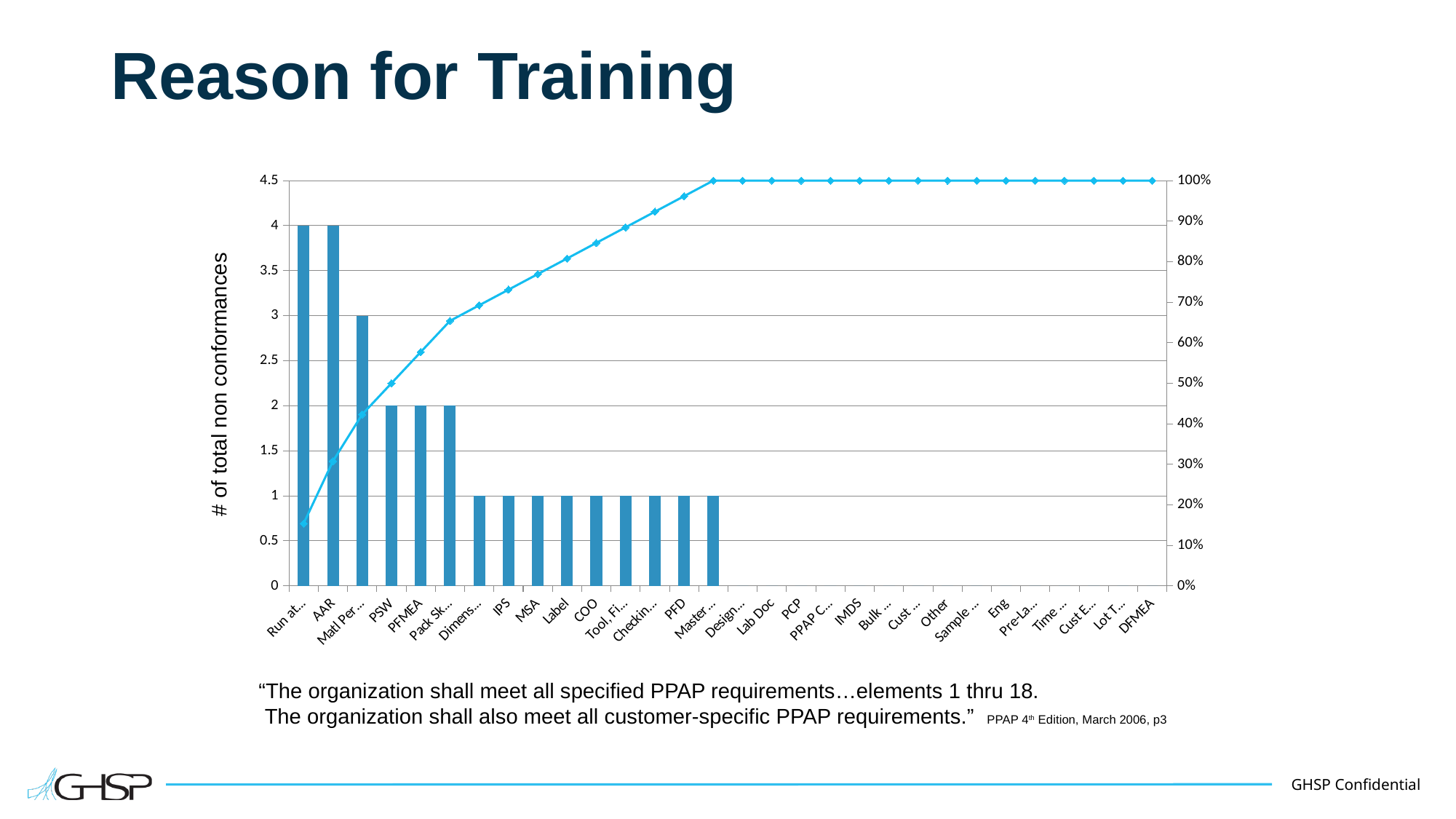
What is the cumulative percentage shown by the line at DFMEA? 100% What is the difference between the number of non conformances for AAR and for PSW? 2 How many categories are shown on the x axis? 30 Which has more non conformances, AAR or MSA? AAR What is the number of non conformances for AAR? 4 What is the number of non conformances for DFMEA? 0 What is the number of non conformances for IPS? 1 What is the number of non conformances for PSW? 2 What is the label of the left vertical axis? # of total non conformances Do the bar values rise or fall from left to right along the x axis? Fall Which has more non conformances, PFMEA or Lab Doc? PFMEA What kind of chart is this? Bar chart with a cumulative percentage line